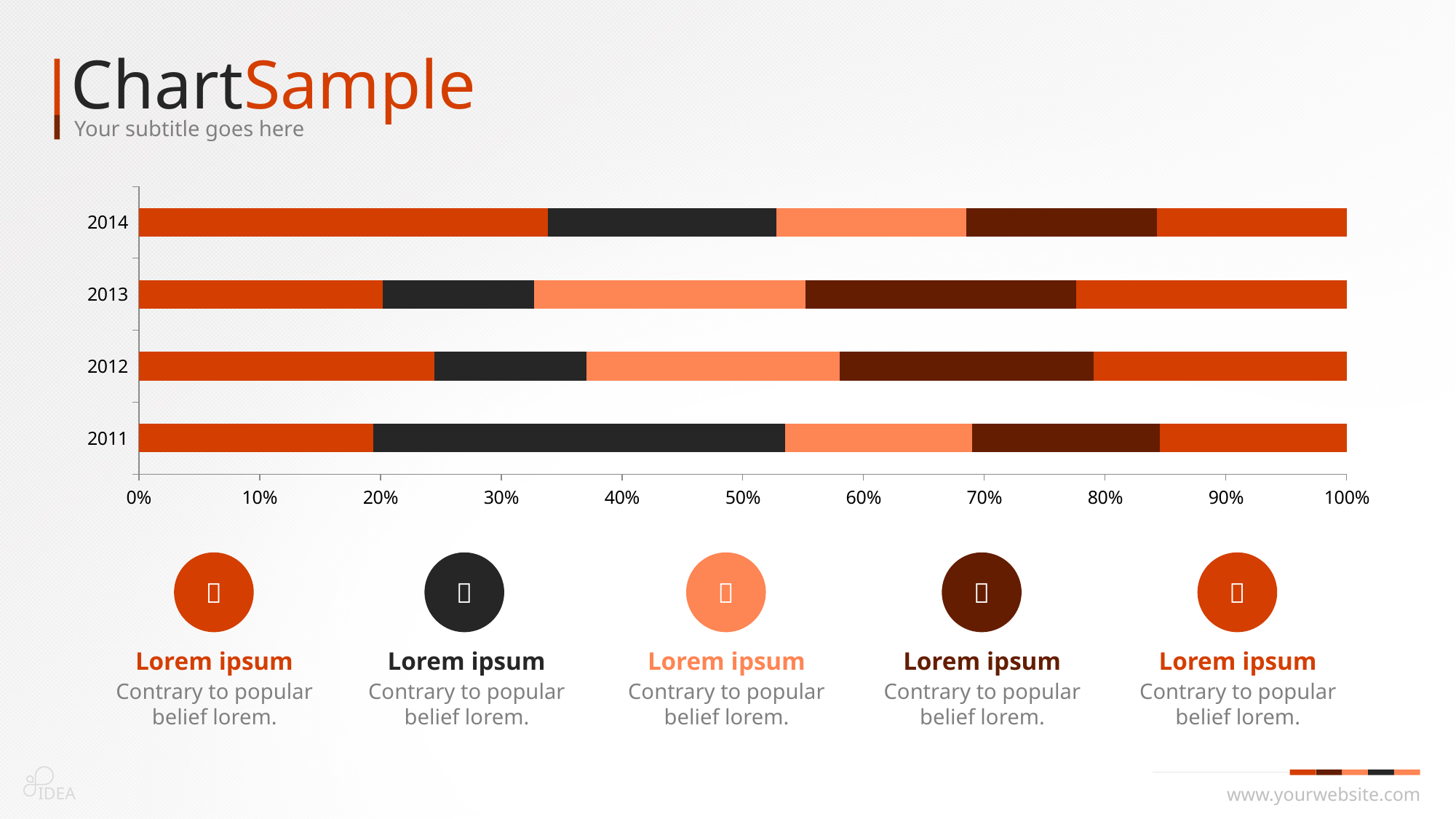
What is the total each stacked bar adds up to on the chart? 100% Which year has the larger leftmost (dark orange) segment, 2014 or 2011? 2014 Which year has the larger black segment, 2011 or 2014? 2011 Which year has the largest black segment? 2011 What is the highest value shown on the horizontal axis of the chart? 100% How many coloured segments make up each bar in the chart? 5 Is the black segment for 2011 greater or less than 30%? greater Is the leftmost (dark orange) segment for 2012 greater or less than 20%? greater Which year has the largest leftmost (dark orange) segment? 2014 Is the leftmost (dark orange) segment for 2014 greater or less than 30%? greater How many years (categories) are plotted on the chart? 4 What type of chart is shown on the slide? Stacked bar chart